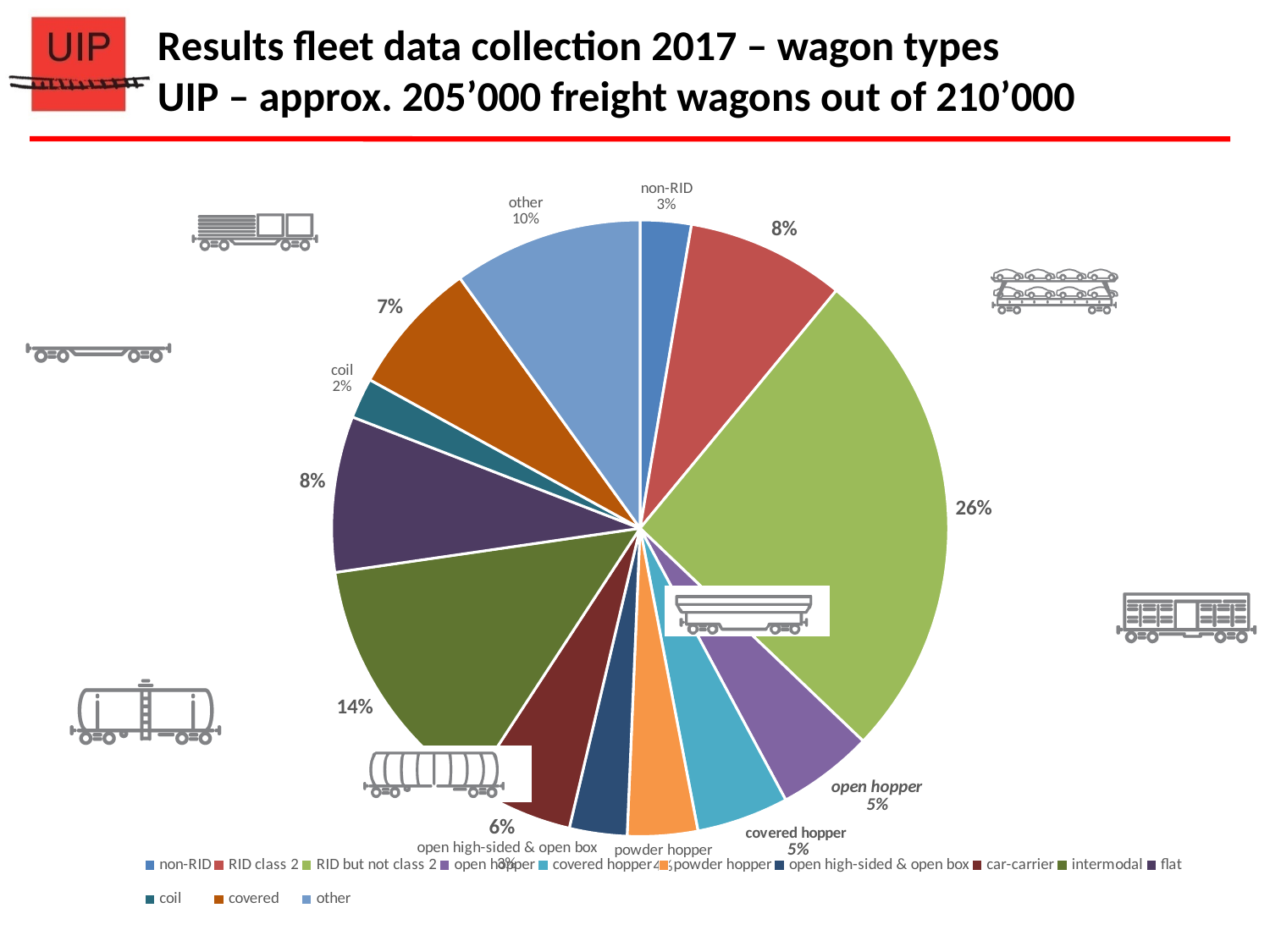
Which labelled wagon type has the smallest slice of the pie? coil Which slice is larger, 'other' or coil? other What kind of chart is shown on the slide? pie chart Which wagon type has the largest slice of the pie? RID but not class 2 What is the share of the largest slice in the pie? 26% What percentage is shown for the covered hopper slice? 5% What percentage is shown for the open hopper slice? 5% What is the difference in percentage points between the 'other' slice and the non-RID slice? 7 How many wagon types are listed in the legend? 13 What percentage is shown for the 'other' slice? 10% What percentage is shown for the coil slice? 2% What share of the pie does the non-RID slice represent? 3%